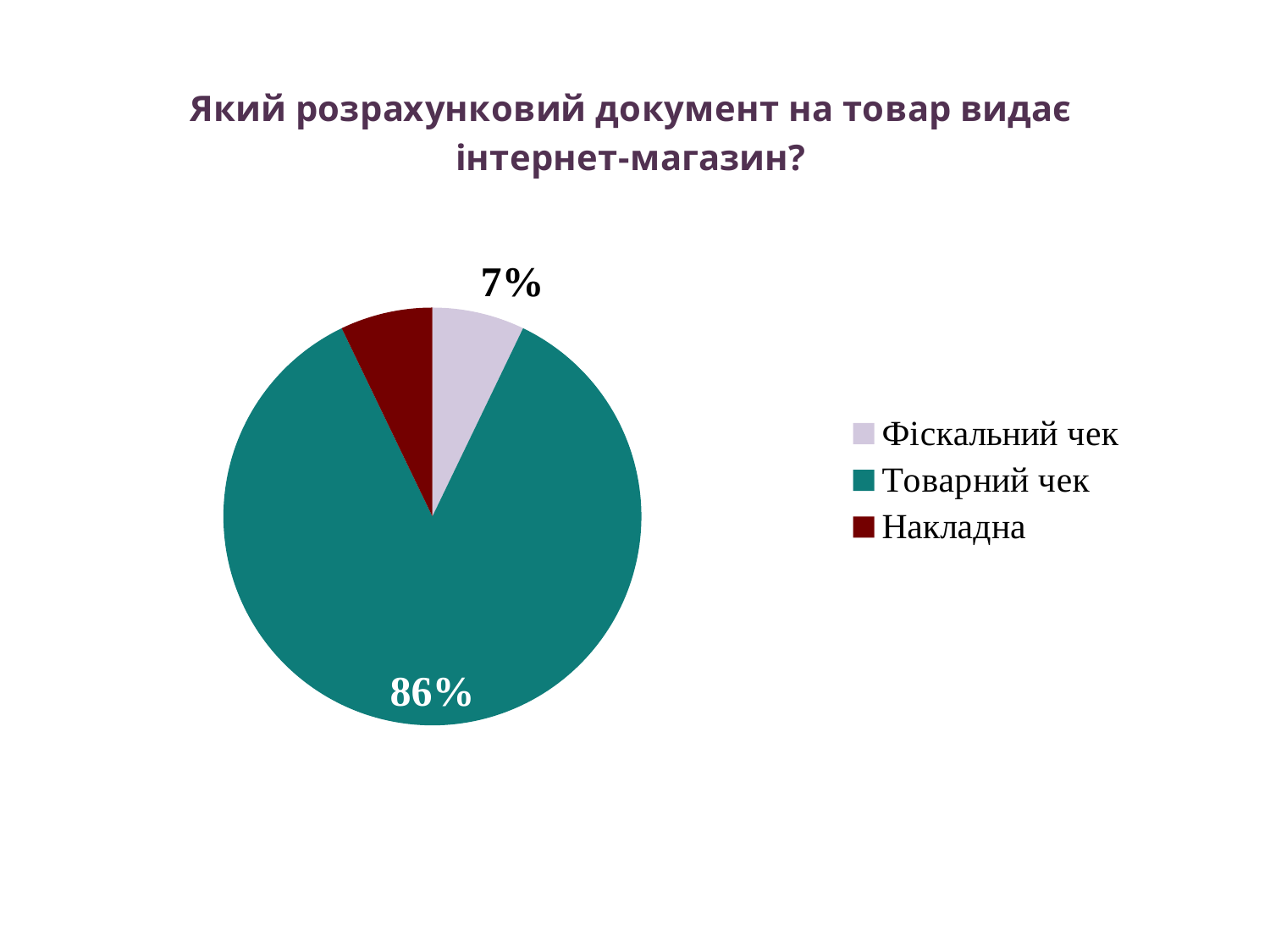
Which is larger, Товарний чек or Фіскальний чек? Товарний чек Which category has the largest slice of the pie? Товарний чек What is the difference in percentage points between Товарний чек and Фіскальний чек? 79 How many entries does the legend list? 3 What colour is the slice for Накладна? Dark red What percentage is shown for Фіскальний чек? 7% How many categories does the pie chart have? 3 What kind of chart is shown on the slide? Pie chart What share of the pie does Товарний чек take? 86% What percentage is shown for Товарний чек? 86% What is the title of the chart? Який розрахунковий документ на товар видає інтернет-магазин?